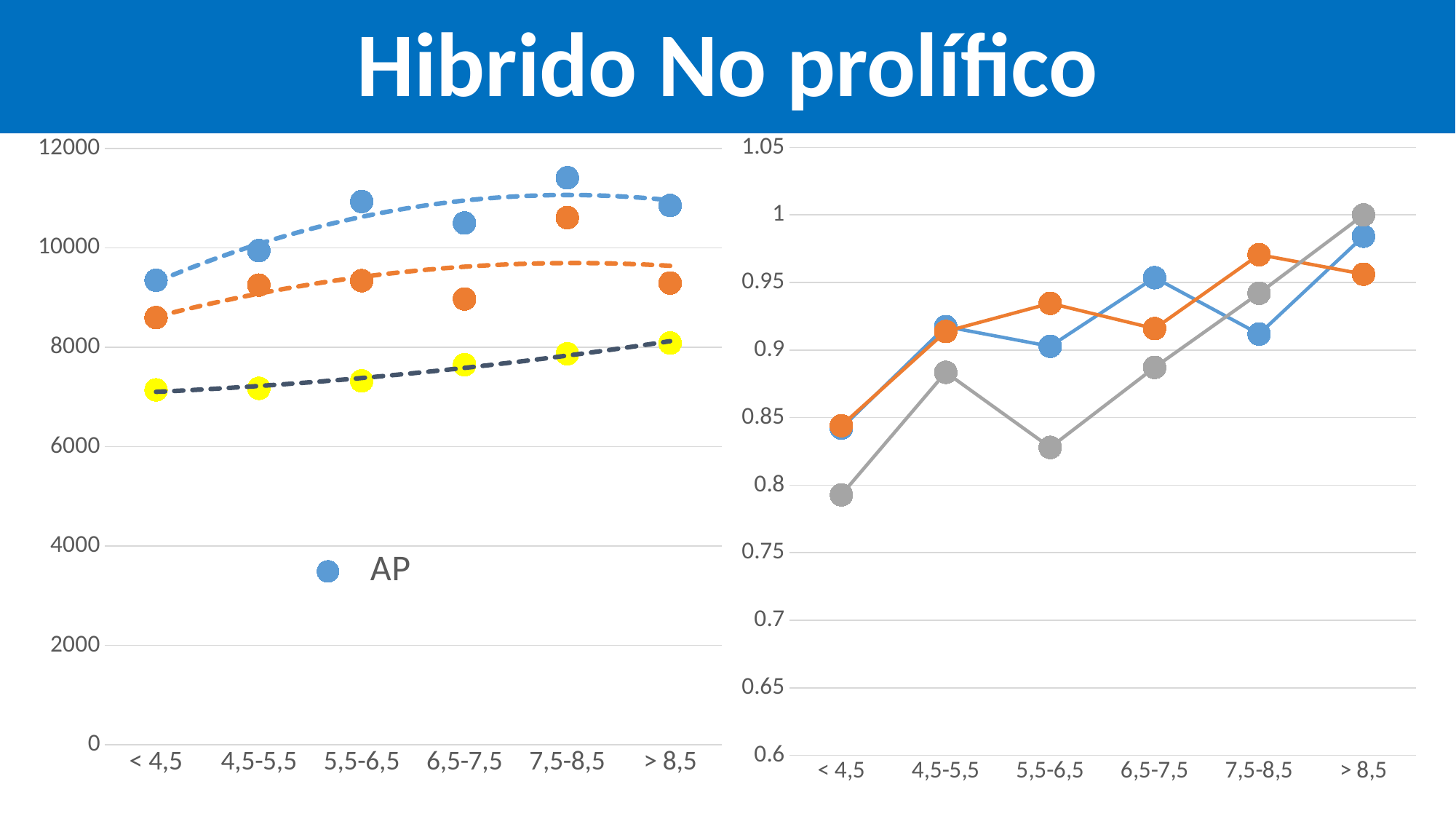
In the left chart, which category has the highest AP value? 7,5-8,5 In the left chart, what is the name of the series shown in the legend? AP In the left chart, how many categories are shown on the x axis? 6 What kind of chart is the chart on the left of the slide? scatter chart In the right chart, is the gray series value for < 4,5 greater or less than 0.85? less In the right chart, which category has the lowest value for the gray series? < 4,5 In the left chart, is the AP value larger for 5,5-6,5 or for 6,5-7,5? 5,5-6,5 In the left chart, is the yellow series value for < 4,5 greater or less than 8000? less In the left chart, is the AP value for 7,5-8,5 greater or less than 10000? greater In the left chart, how many series does the legend list? 1 What kind of chart is the chart on the right of the slide? line chart In the right chart, how many categories are shown on the x axis? 6